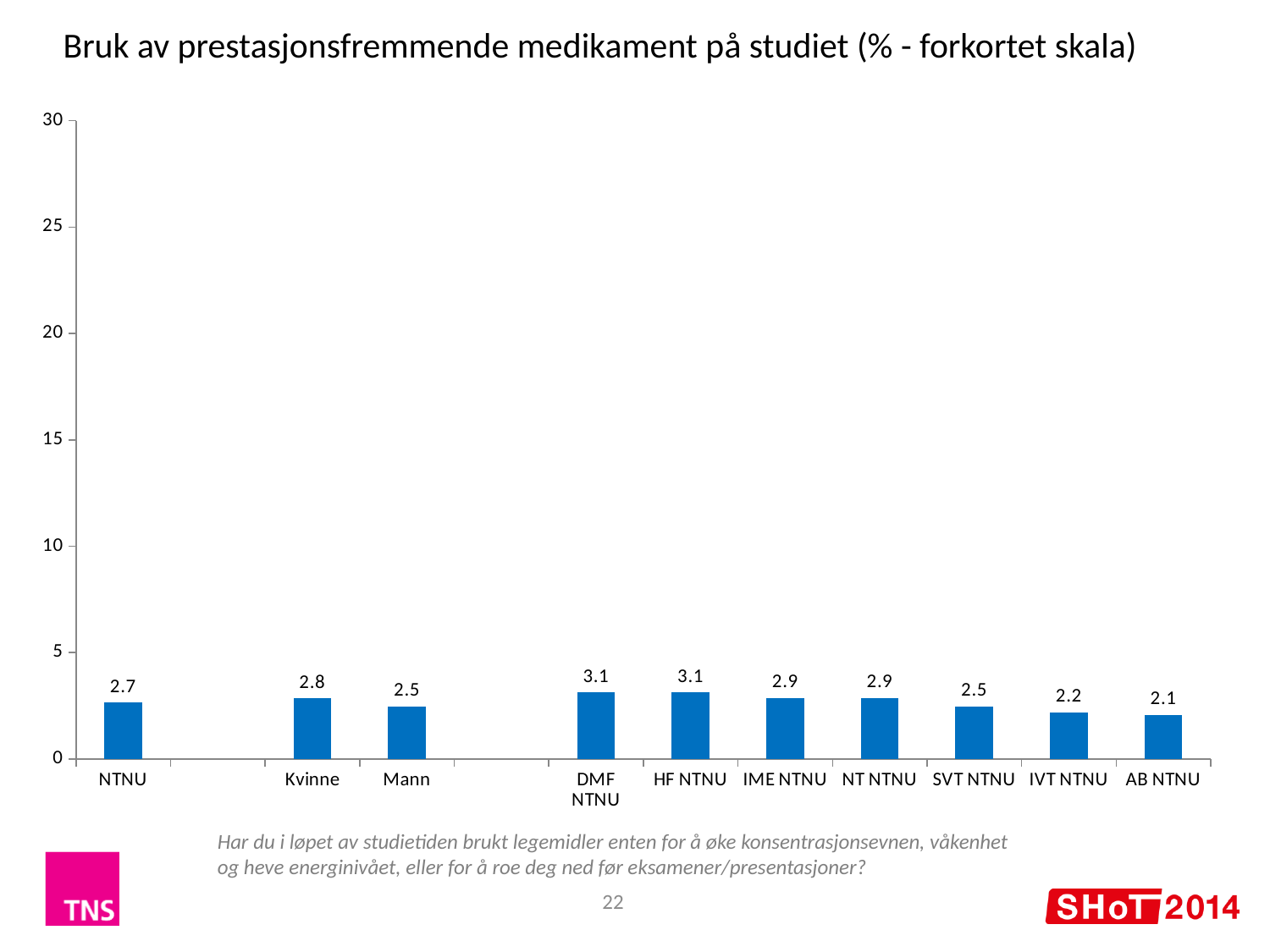
Which category has the lowest value? AB NTNU What is the difference between the values for DMF NTNU and AB NTNU? 1.0 What kind of chart is shown on the slide? bar chart What is the title of the chart? Bruk av prestasjonsfremmende medikament på studiet (% - forkortet skala) What is the value for Kvinne? 2.8 What is the value for IVT NTNU? 2.2 How many bars are shown in the chart? 10 What is the value for NTNU? 2.7 What is the difference between the values for Kvinne and Mann? 0.3 What is the value for SVT NTNU? 2.5 Is the value for HF NTNU greater or less than 5? less Which is larger, the value for IME NTNU or the value for IVT NTNU? IME NTNU